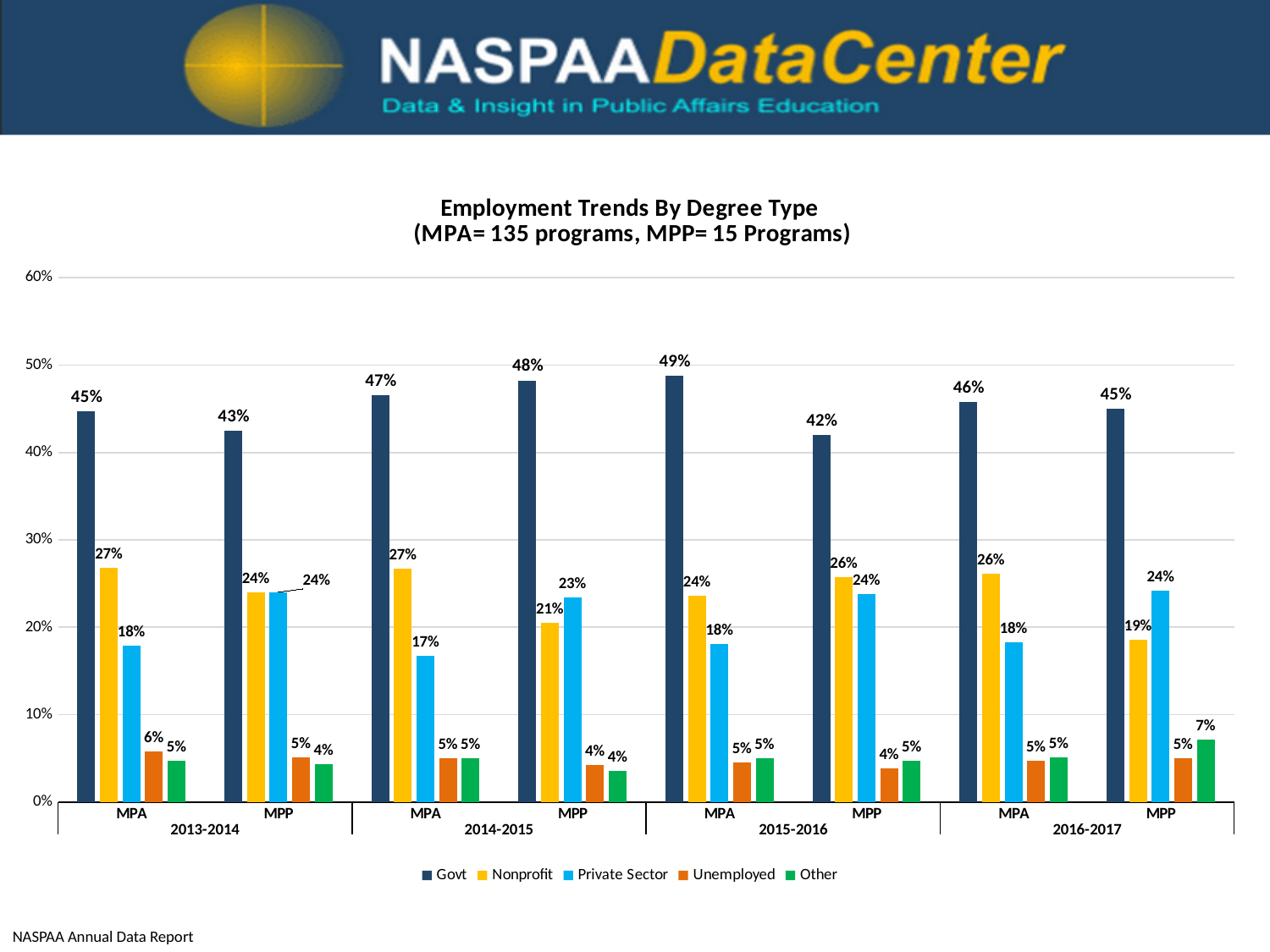
What is the difference between the Govt values for MPA and MPP in 2015-2016? 7% What is the Private Sector value for MPA in 2014-2015? 17% What is the Other value for MPP in 2016-2017? 7% What kind of chart is shown on the slide? Bar chart What is the Nonprofit value for MPP in 2016-2017? 19% How many academic years are shown on the x axis? 4 In which year and degree type is the Govt value highest? MPA, 2015-2016 What is the Govt value for MPA in 2015-2016? 49% Which is larger in 2014-2015: the Govt value for MPA or for MPP? MPP What is the difference between the Unemployed value for MPA in 2013-2014 and the Unemployed value for MPP in 2013-2014? 1% How many series does the legend list? 5 In which year and degree type is the Govt value lowest? MPP, 2015-2016